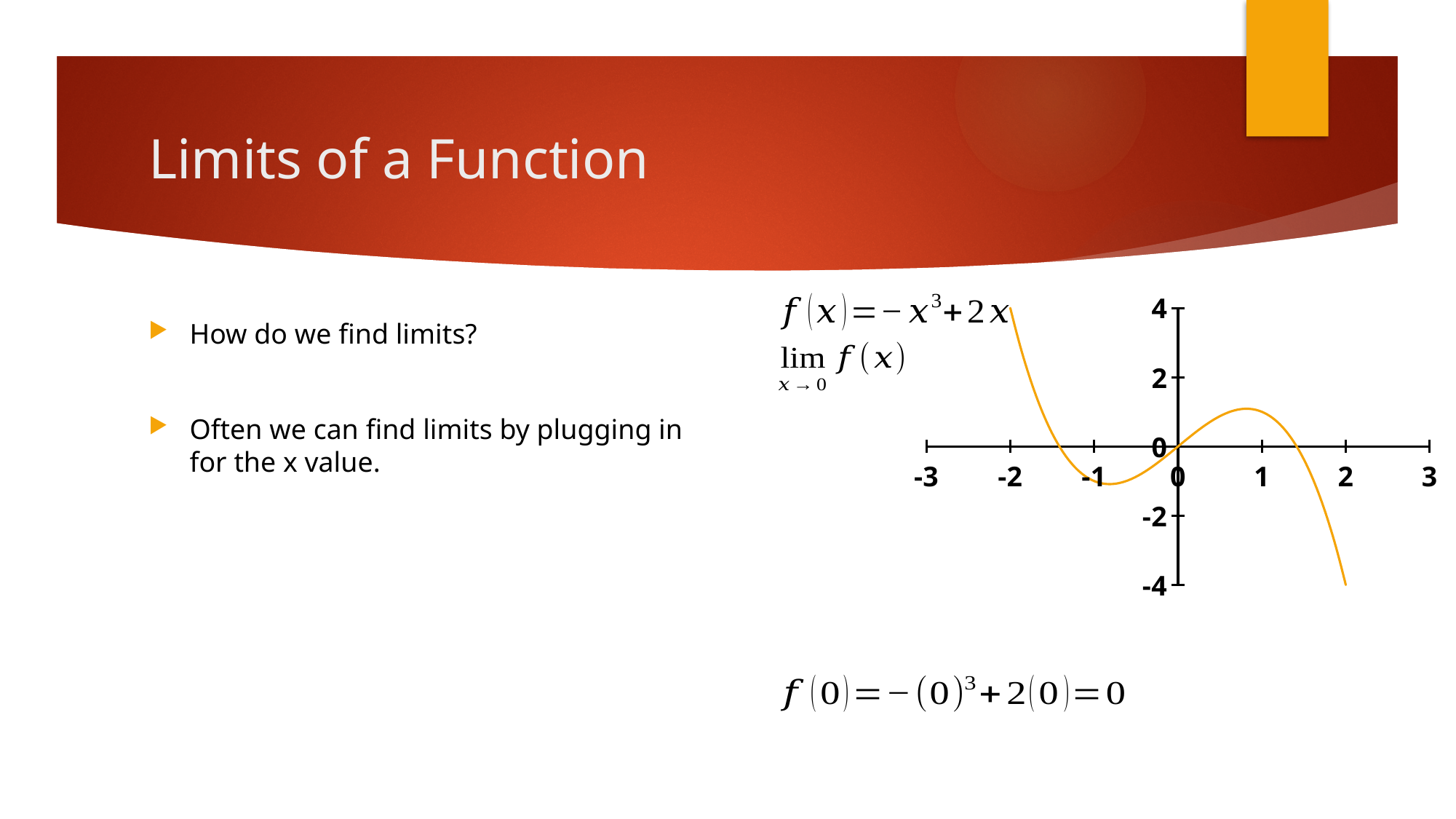
What is the value of the plotted curve at x = -2? 4 Which is larger, the value of the curve at x = 1 or at x = -1? x = 1 Does the curve rise or fall as x goes from 0 to 1? rise What is the value of the plotted curve at x = 2? -4 Is the value of the curve at x = 1 greater or less than 2? less Is the value of the curve at x = 1 greater or less than 0? greater Is the value of the curve at x = -1 greater or less than 0? less What is the highest value labelled on the vertical axis of the chart? 4 What kind of chart is shown on the right of the slide? line chart What is the value of the plotted curve at x = 0? 0 Does the curve rise or fall as x goes from 1 to 2? fall Which is larger, the value of the curve at x = -2 or at x = 2? x = -2